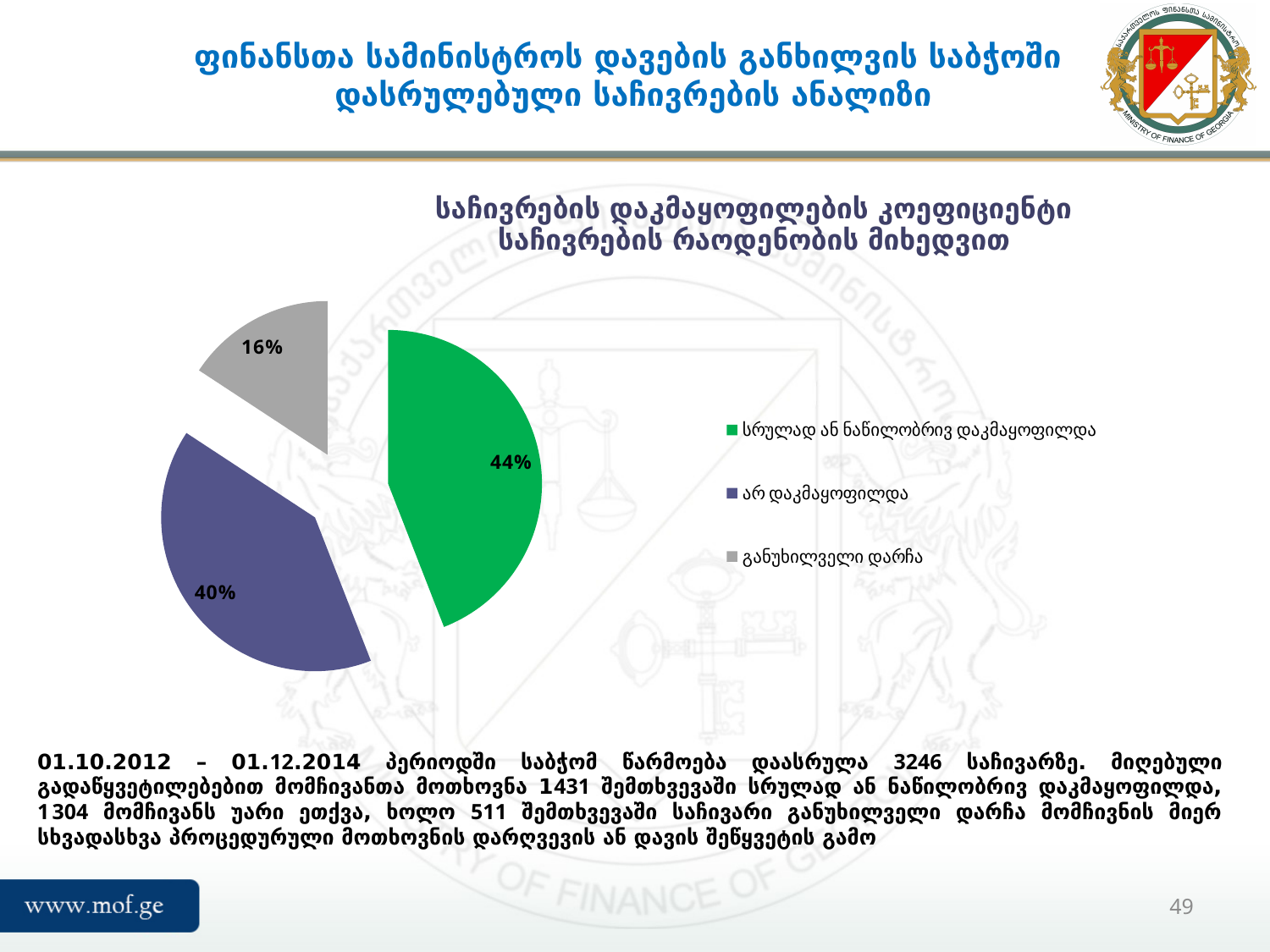
Which category has the smallest slice of the pie? განუხილველი დარჩა What kind of chart is shown on the slide? Pie chart What is the difference in percentage points between the "სრულად ან ნაწილობრივ დაკმაყოფილდა" slice and the "არ დაკმაყოფილდა" slice? 4 percentage points Which is larger: the "არ დაკმაყოფილდა" slice or the "განუხილველი დარჩა" slice? არ დაკმაყოფილდა What is the difference in percentage points between the "არ დაკმაყოფილდა" slice and the "განუხილველი დარჩა" slice? 24 percentage points What share of the pie does the slice "არ დაკმაყოფილდა" represent? 40% How many slices does the pie chart have? 3 What share of the pie does the slice "განუხილველი დარჩა" represent? 16% Which category has the largest slice of the pie? სრულად ან ნაწილობრივ დაკმაყოფილდა What colour is the slice for "განუხილველი დარჩა"? Grey What share of the pie does the slice "სრულად ან ნაწილობრივ დაკმაყოფილდა" represent? 44% How many entries does the legend list? 3